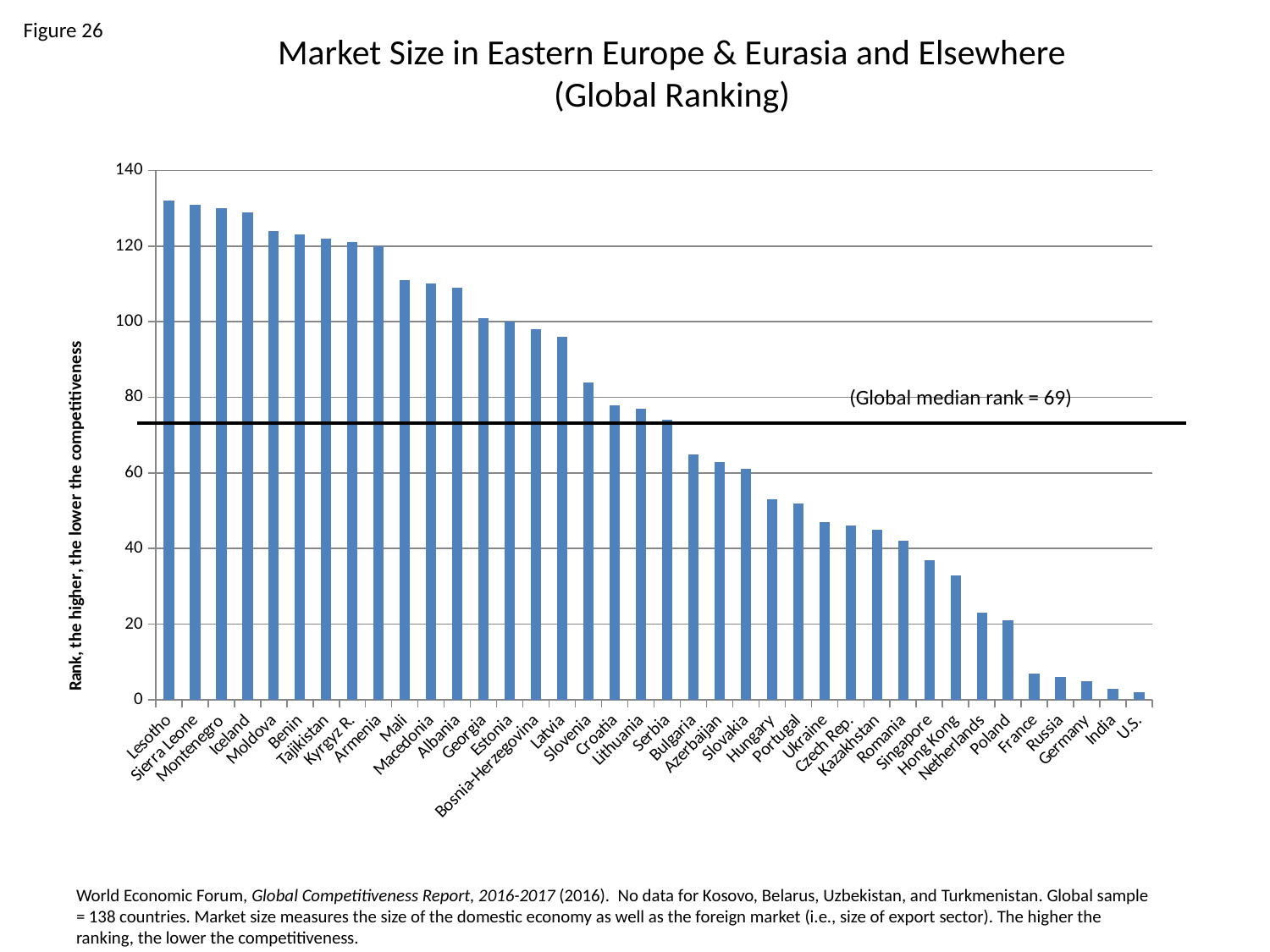
Is the value for Bulgaria greater or less than 80? less What global median rank is indicated by the horizontal line on the chart? 69 Is the value for Hungary greater or less than 60? less Which has a higher rank value, Croatia or Romania? Croatia Do the bar values rise or fall moving from left to right along the x axis? fall How many countries are shown in the chart? 38 Which country has the lowest market size rank in the chart? U.S. Which country has the highest market size rank in the chart? Lesotho Is the value for Slovenia greater or less than 80? greater What kind of chart is shown on the slide? bar chart